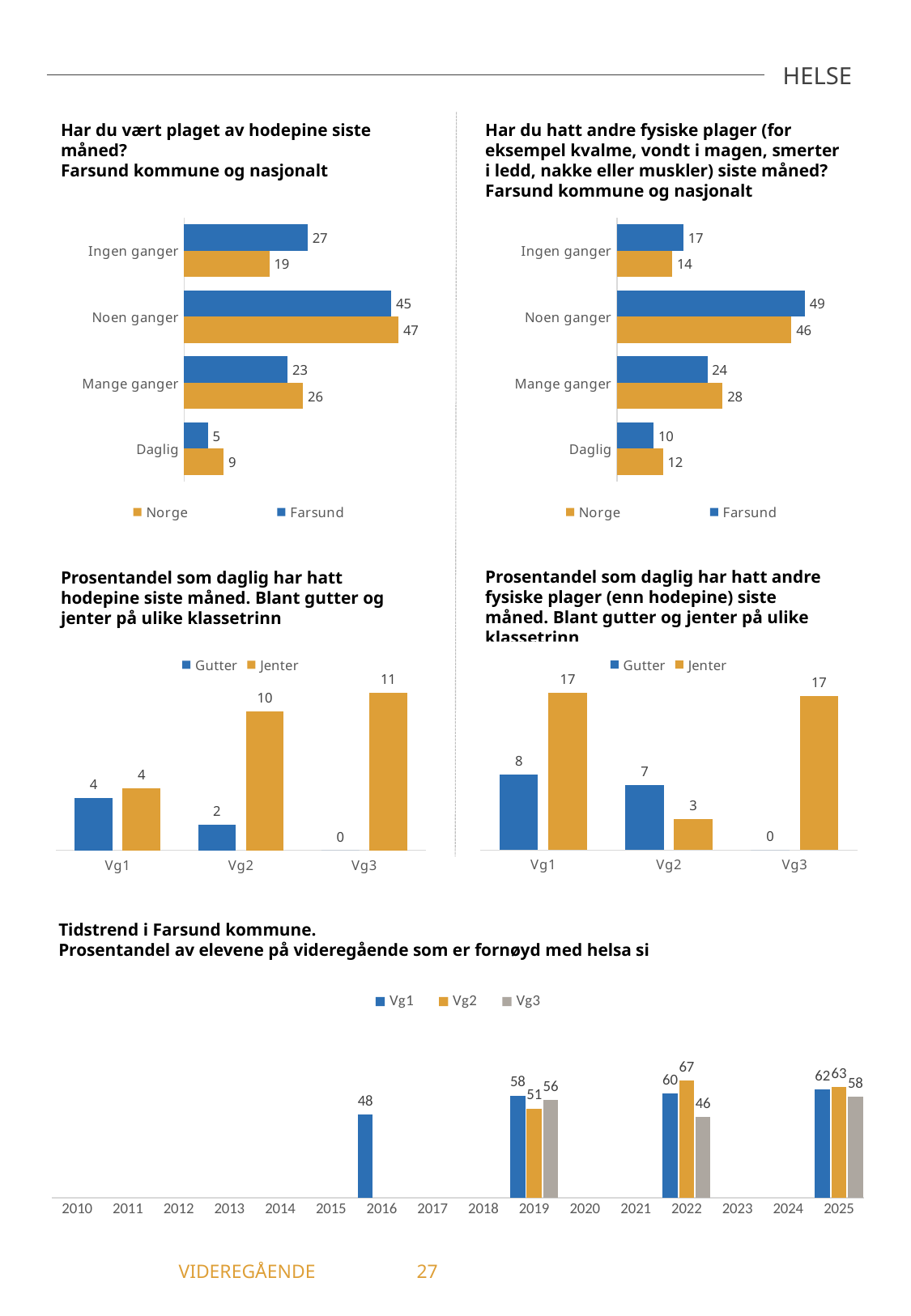
In the chart 'Prosentandel som daglig har hatt hodepine siste måned', how many series does the legend list? 2 In the chart 'Tidstrend i Farsund kommune', what is the value for Vg2 in 2022? 67 What kind of chart is 'Tidstrend i Farsund kommune'? bar chart In the chart 'Prosentandel som daglig har hatt andre fysiske plager (enn hodepine)', what is the difference between Jenter and Gutter in Vg1? 9 In the chart 'Har du hatt andre fysiske plager ... siste måned?', which is larger for 'Ingen ganger': Norge or Farsund? Farsund In the chart 'Har du hatt andre fysiske plager ... siste måned?', which category has the highest value for Farsund? Noen ganger In the chart 'Prosentandel som daglig har hatt hodepine siste måned', what is the value for Jenter in Vg3? 11 In the chart 'Prosentandel som daglig har hatt andre fysiske plager (enn hodepine)', which is larger in Vg2: Gutter or Jenter? Gutter In the chart 'Har du vært plaget av hodepine siste måned?', what is the value for Farsund for 'Noen ganger'? 45 In the chart 'Har du vært plaget av hodepine siste måned?', what is the difference between Norge and Farsund for 'Daglig'? 4 In the chart 'Tidstrend i Farsund kommune', does the value for Vg1 rise or fall from 2016 to 2025? rise In the chart 'Har du hatt andre fysiske plager ... siste måned?', what is the value for Norge for 'Mange ganger'? 28